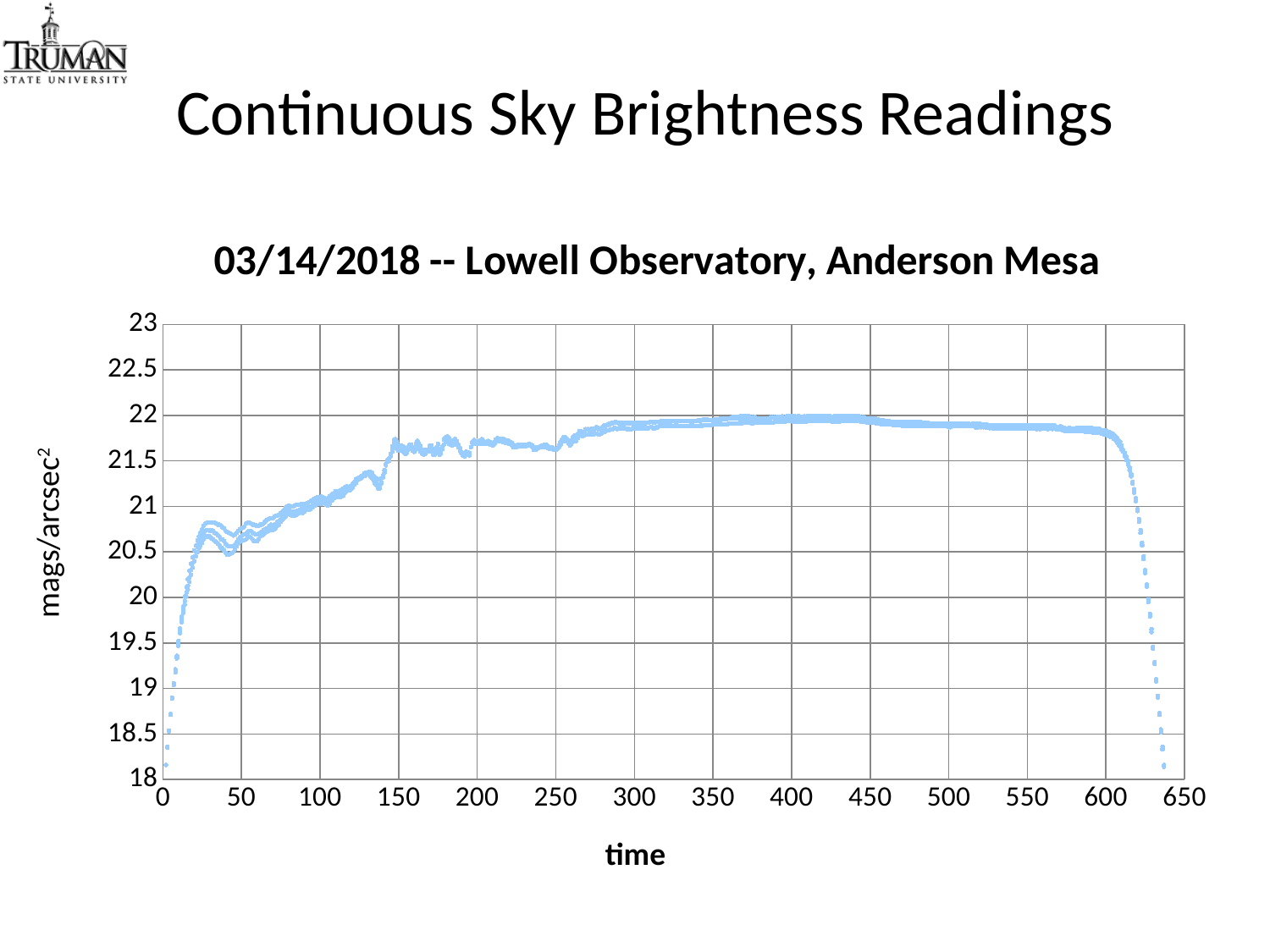
What kind of chart is shown on the slide? scatter chart What is the label on the vertical axis of the chart? mags/arcsec² Do the values rise or fall between time 0 and time 150? rise What is the title of the chart? 03/14/2018 -- Lowell Observatory, Anderson Mesa Is the value at time 300 greater or less than 21.5? greater Is the value at time 50 greater or less than 21? less Is the value at time 0 greater or less than 19? less Do the values rise or fall between time 600 and time 640? fall